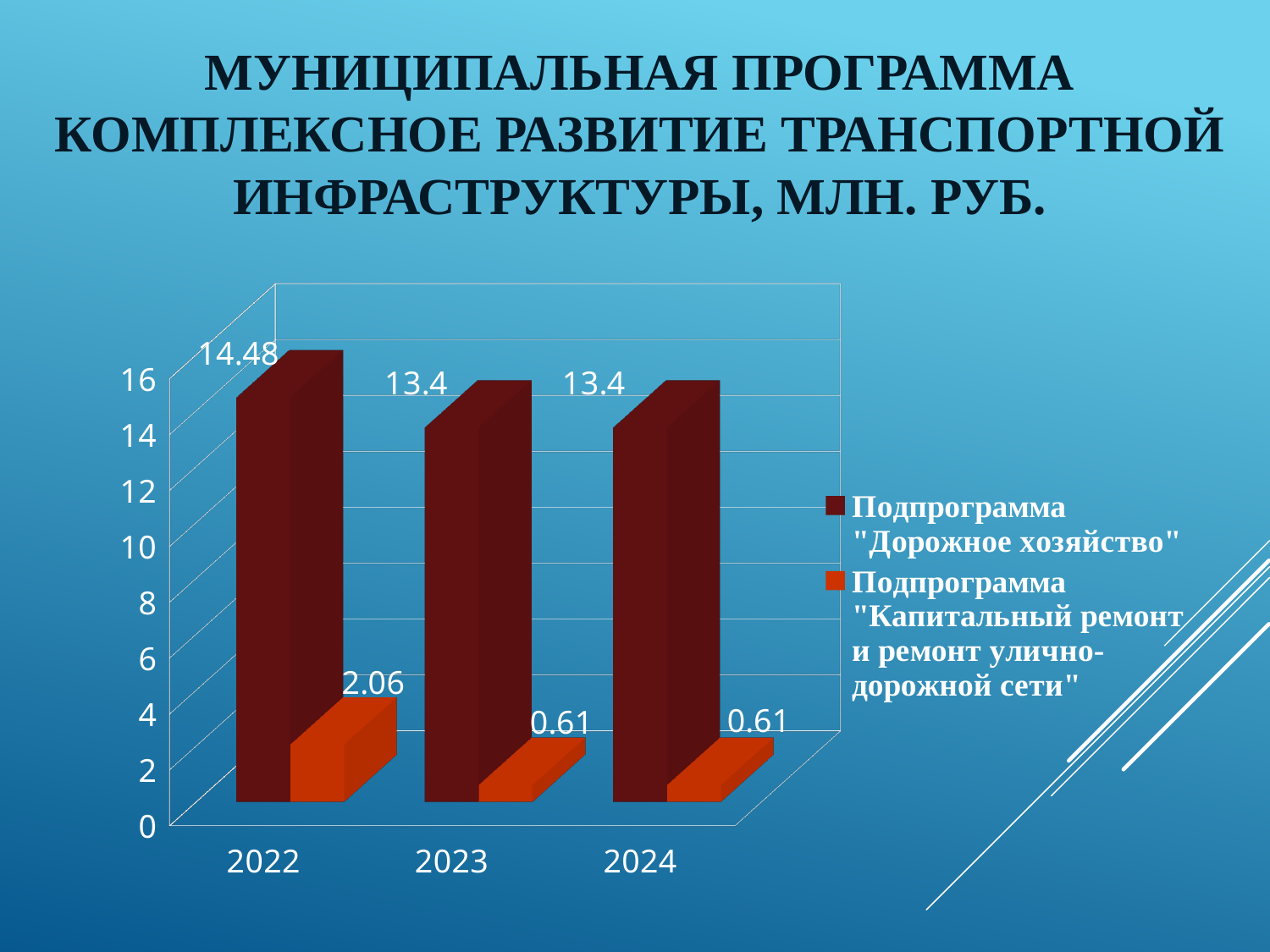
What is the difference between the 2022 and 2024 values for Подпрограмма "Капитальный ремонт и ремонт улично-дорожной сети"? 1.45 What is the value for Подпрограмма "Дорожное хозяйство" in 2022? 14.48 What kind of chart is shown on the slide? Bar chart What is the difference between the 2022 and 2023 values for Подпрограмма "Дорожное хозяйство"? 1.08 Which is larger in 2023: Подпрограмма "Дорожное хозяйство" or Подпрограмма "Капитальный ремонт и ремонт улично-дорожной сети"? Подпрограмма "Дорожное хозяйство" What is the value for Подпрограмма "Капитальный ремонт и ремонт улично-дорожной сети" in 2023? 0.61 What is the value for Подпрограмма "Капитальный ремонт и ремонт улично-дорожной сети" in 2022? 2.06 In which year is the value for Подпрограмма "Капитальный ремонт и ремонт улично-дорожной сети" highest? 2022 How many series does the legend list? 2 How many years are shown on the x axis? 3 What is the value for Подпрограмма "Дорожное хозяйство" in 2024? 13.4 In which year is the value for Подпрограмма "Дорожное хозяйство" highest? 2022